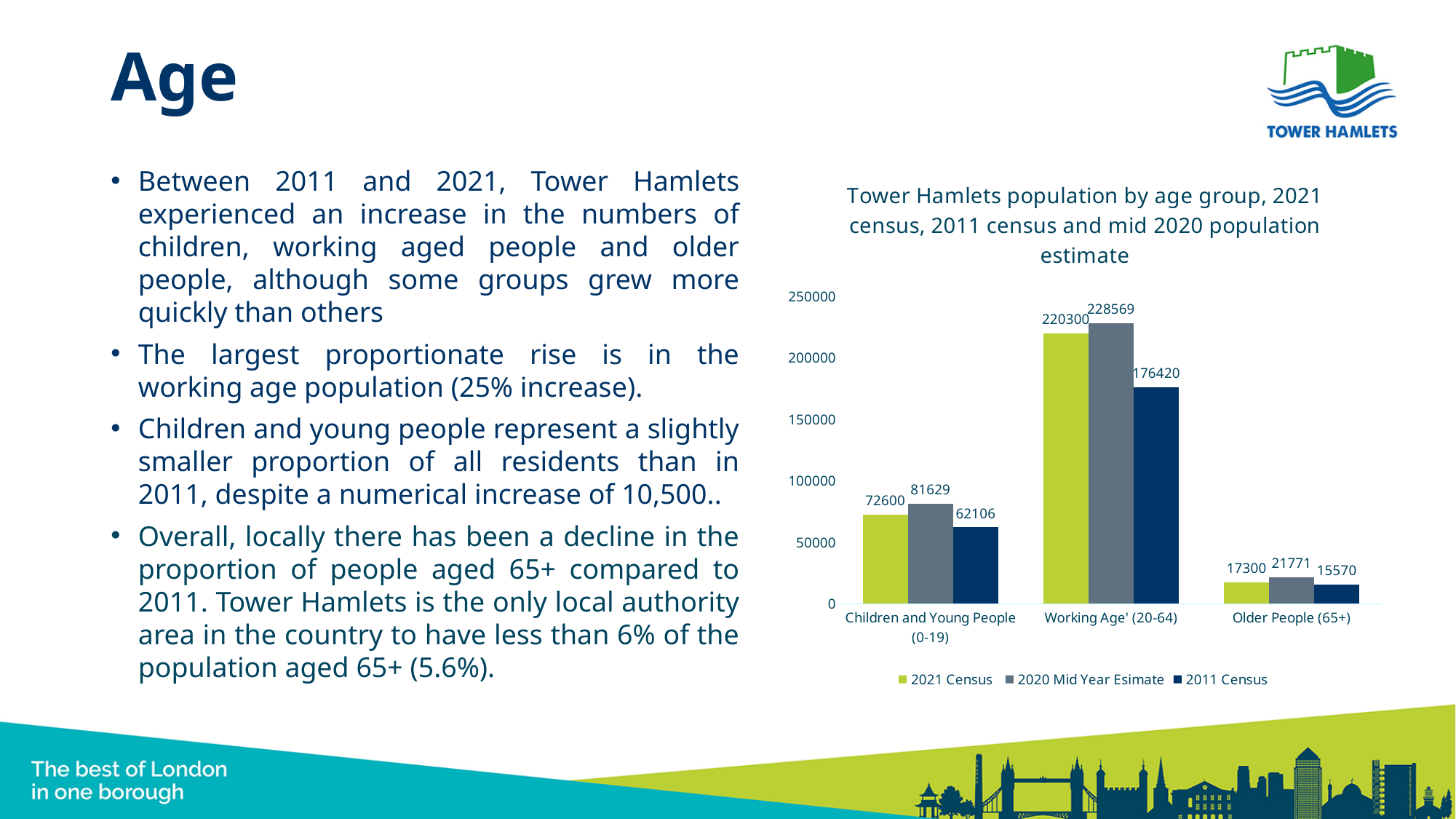
What is the title of the chart? Tower Hamlets population by age group, 2021 census, 2011 census and mid 2020 population estimate Which age group has the highest 2021 Census value? Working Age (20-64) How many age group categories are shown on the x axis of the chart? 3 What is the difference between the 2021 Census and 2011 Census values for Working Age (20-64)? 43880 What is the 2021 Census value for Working Age (20-64)? 220300 What is the 2011 Census value for Children and Young People (0-19)? 62106 How many series does the chart legend list? 3 Which age group has the lowest 2011 Census value? Older People (65+) Is the 2011 Census value for Working Age (20-64) greater or less than 150000? greater For Children and Young People (0-19), which is larger: the 2020 Mid Year Estimate or the 2021 Census value? 2020 Mid Year Estimate What type of chart is shown on the slide? Bar chart What is the 2020 Mid Year Estimate value for Older People (65+)? 21771